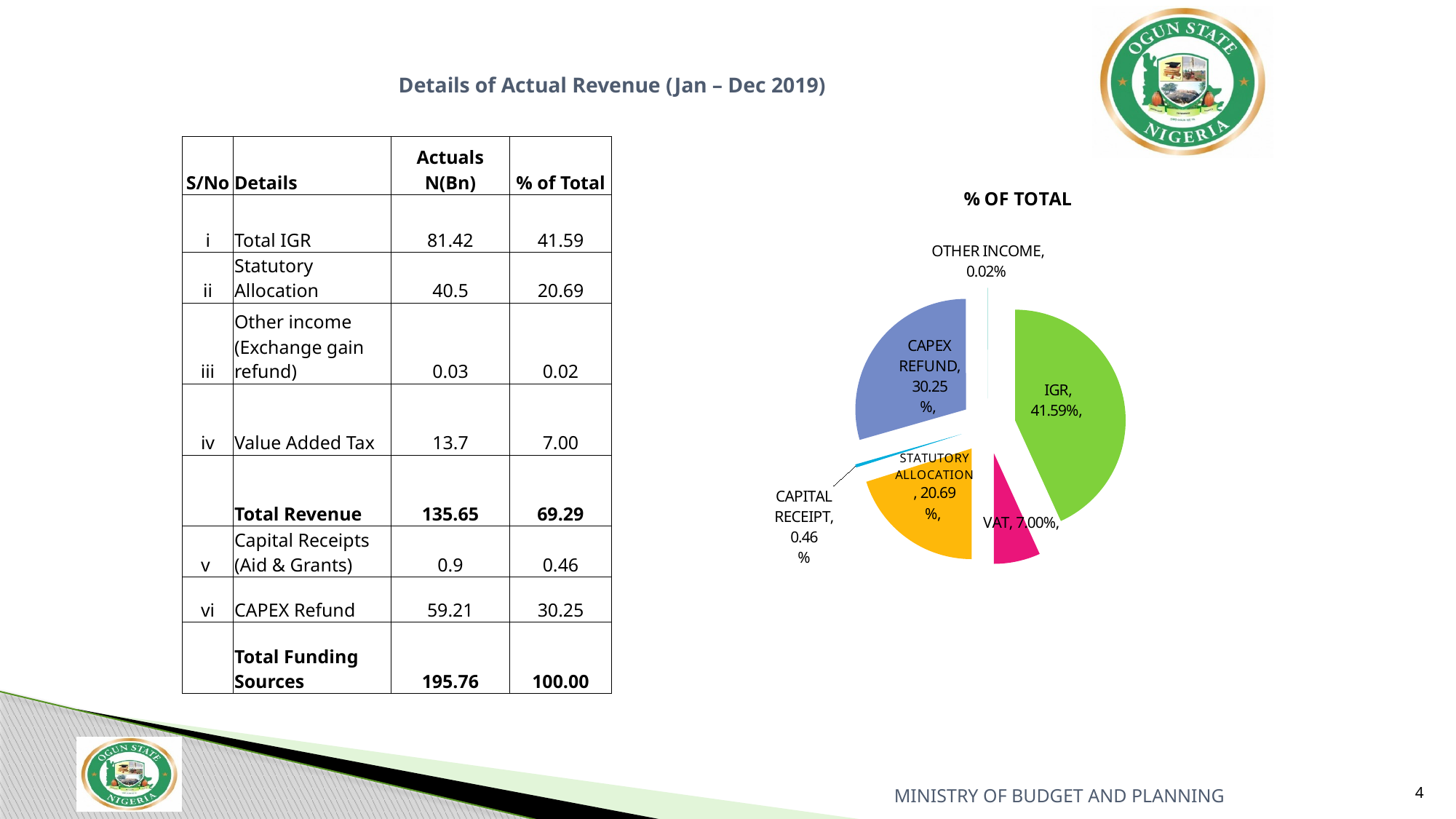
Which slice of the pie chart is the smallest? OTHER INCOME What is the difference between the IGR and CAPEX REFUND values in the pie chart? 11.34% How many slices does the pie chart have? 6 Which is larger in the pie chart, CAPEX REFUND or STATUTORY ALLOCATION? CAPEX REFUND What is the value shown for CAPEX REFUND in the pie chart? 30.25% What type of chart is shown on the slide? pie chart What is the value shown for CAPITAL RECEIPT in the pie chart? 0.46% What is the value shown for STATUTORY ALLOCATION in the pie chart? 20.69% What is the title of the chart? % OF TOTAL What is the value shown for VAT in the pie chart? 7.00% What is the value shown for IGR in the pie chart? 41.59% Which slice of the pie chart is the largest? IGR